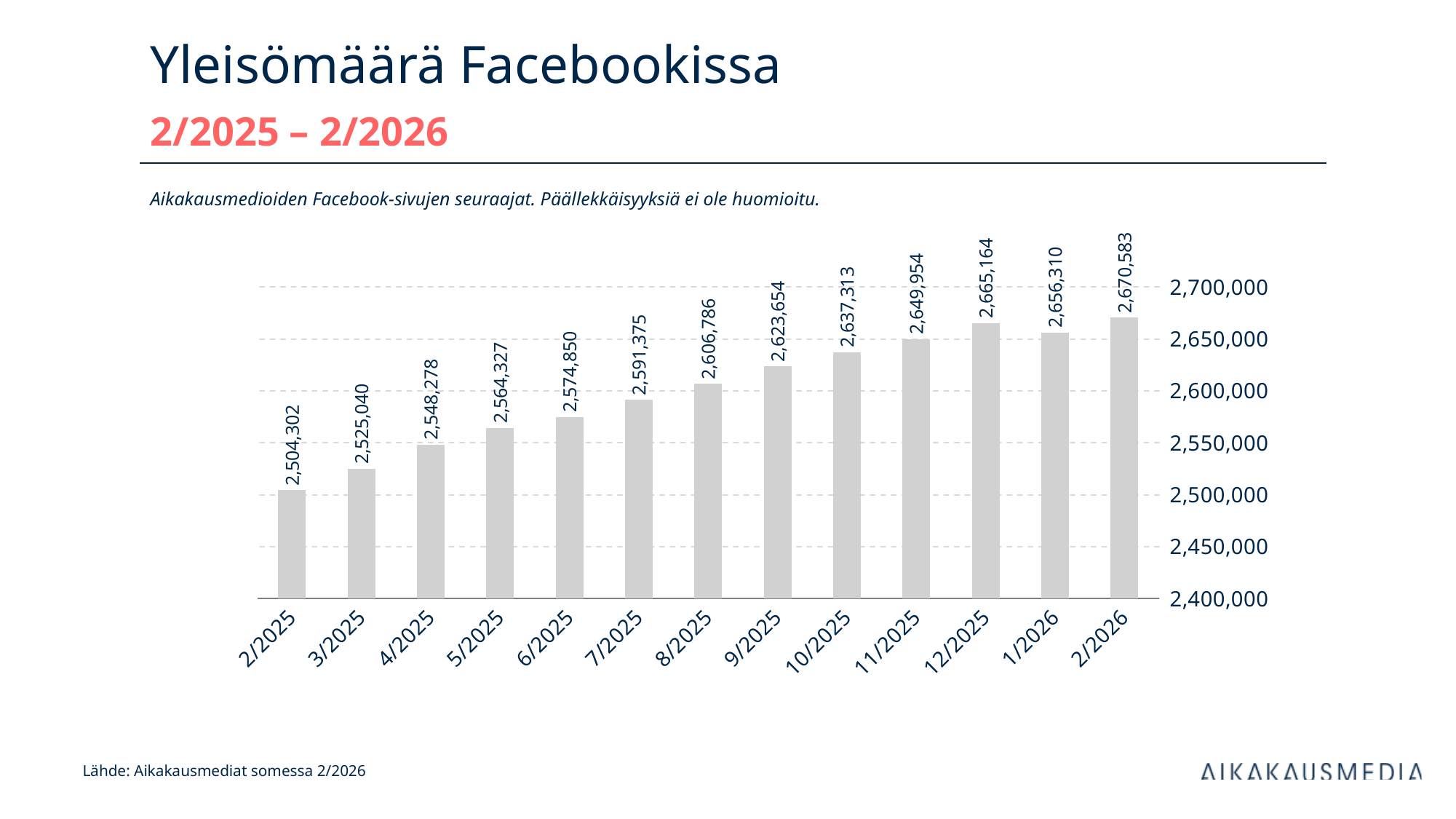
What kind of chart is shown on the slide? bar chart Which month has the highest value? 2/2026 Do the values generally rise or fall from 2/2025 to 2/2026? rise Is the value for 7/2025 greater or less than 2,600,000? less How many months are shown on the chart? 13 What is the value for 8/2025? 2,606,786 What is the value for 2/2025? 2,504,302 Which month has the lowest value? 2/2025 What is the difference between the values for 12/2025 and 1/2026? 8,854 What is the difference between the values for 2/2026 and 2/2025? 166,281 Which is larger, the value for 12/2025 or the value for 1/2026? 12/2025 What is the value for 1/2026? 2,656,310